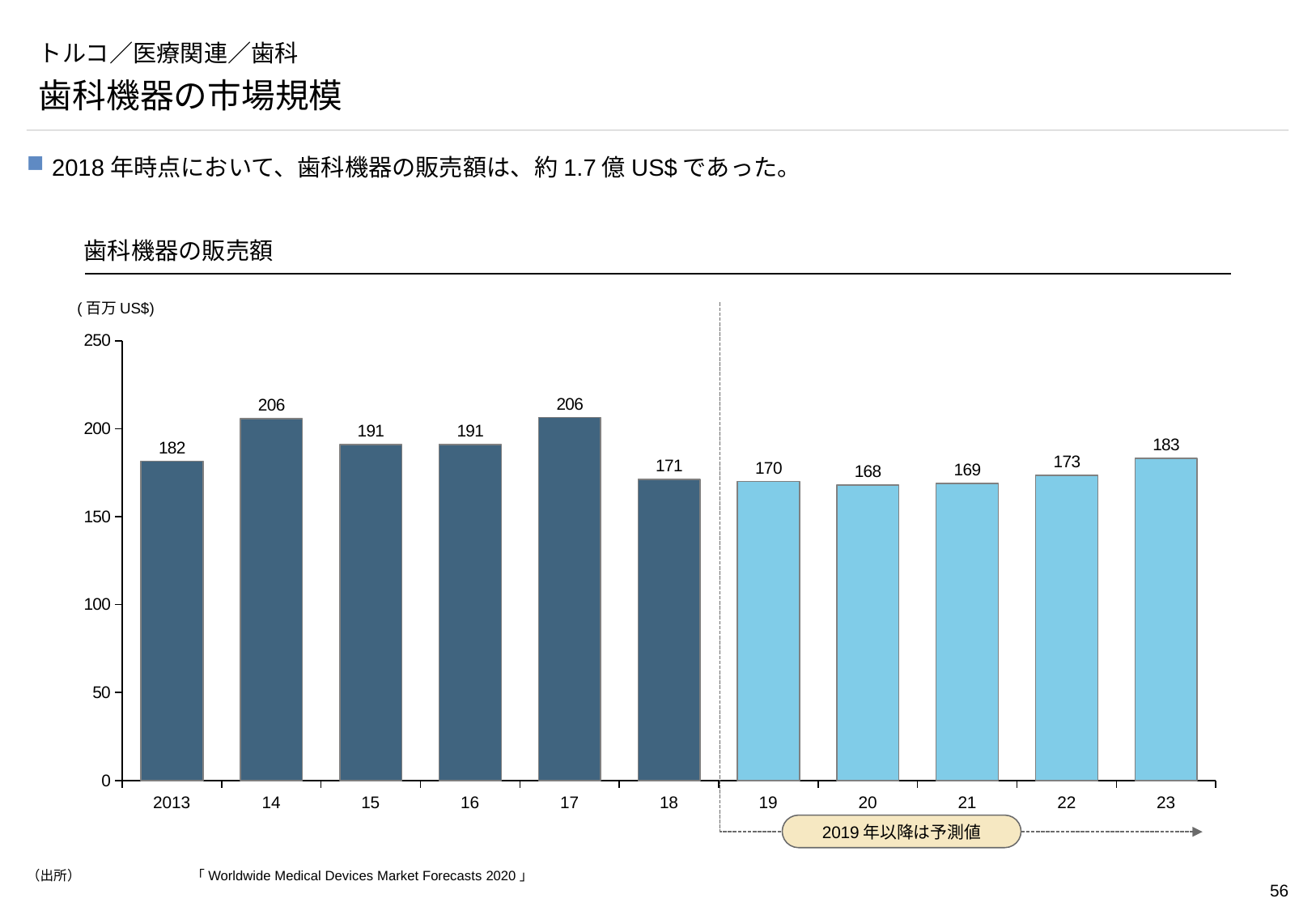
What is the value for 18 (2018) in the chart? 171 What kind of chart is shown on the slide? bar chart How many years (bars) are shown in the chart? 11 Is the value for 17 greater or less than 200? greater What is the forecast value for 23 (2023)? 183 Do the values rise or fall from 19 to 23? rise What is the highest value shown in the chart? 206 Which year has the lowest value in the chart? 20 What unit is shown on the y axis of the chart? 百万 US$ Which is larger, the value for 15 or the value for 19? 15 What is the value for 2013 in the 歯科機器の販売額 chart? 182 What is the difference between the values for 14 and 18? 35